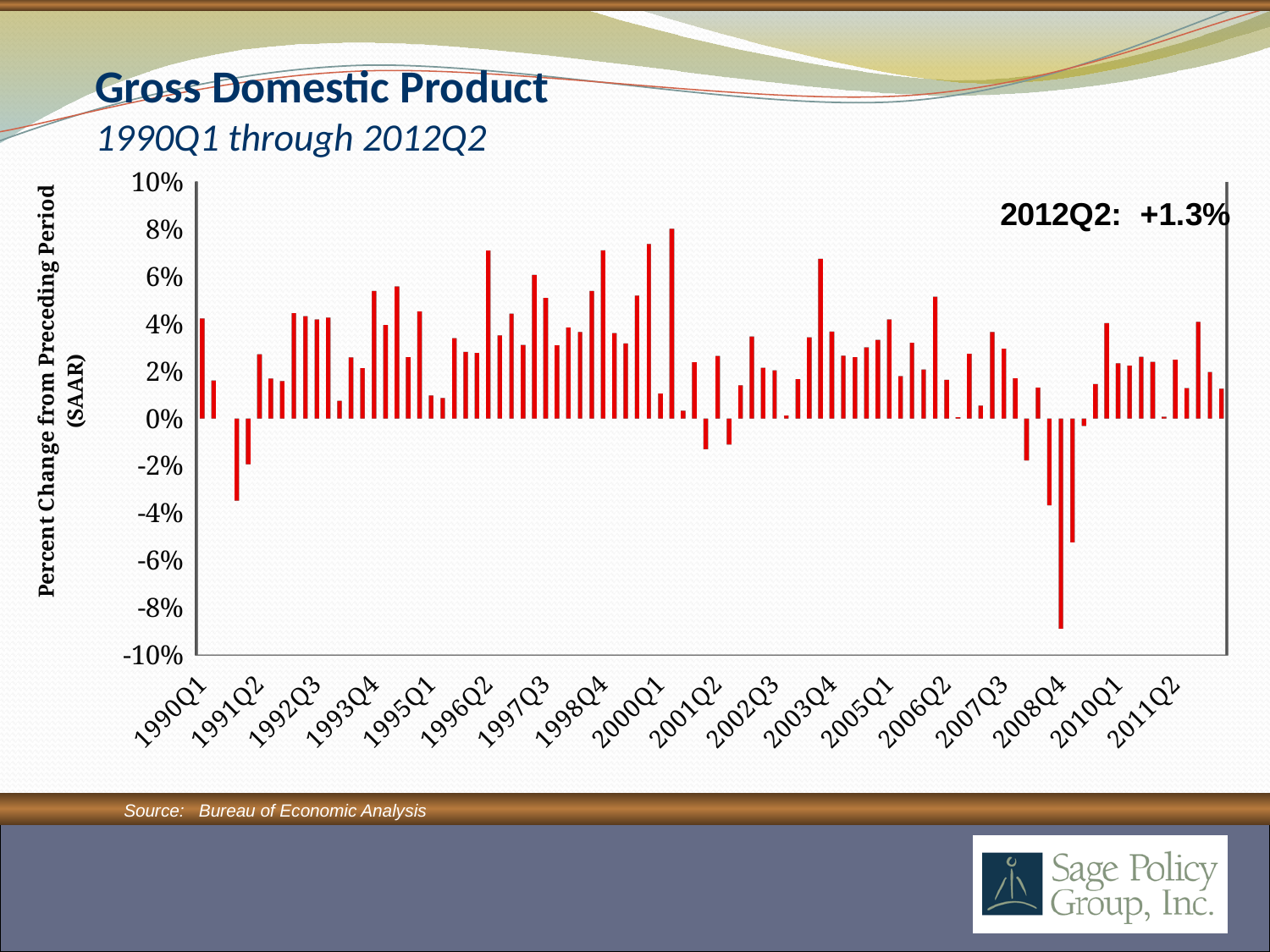
Which is larger, the value for 2012Q2 or the value for 1990Q1? 1990Q1 What is the lowest value shown on the vertical axis? -10% How many quarter labels are printed along the x axis? 18 What is the title of the chart? Gross Domestic Product Is the value for 1990Q1 greater or less than 2%? greater What kind of chart is shown on the slide? Bar chart Is the value for 2012Q2 greater or less than 2%? less Is the value of the lowest bar on the chart greater or less than -6%? less What is the highest value shown on the vertical axis? 10% What is the GDP percent change value shown for 2012Q2? +1.3% What is the label on the vertical axis of the chart? Percent Change from Preceding Period (SAAR)